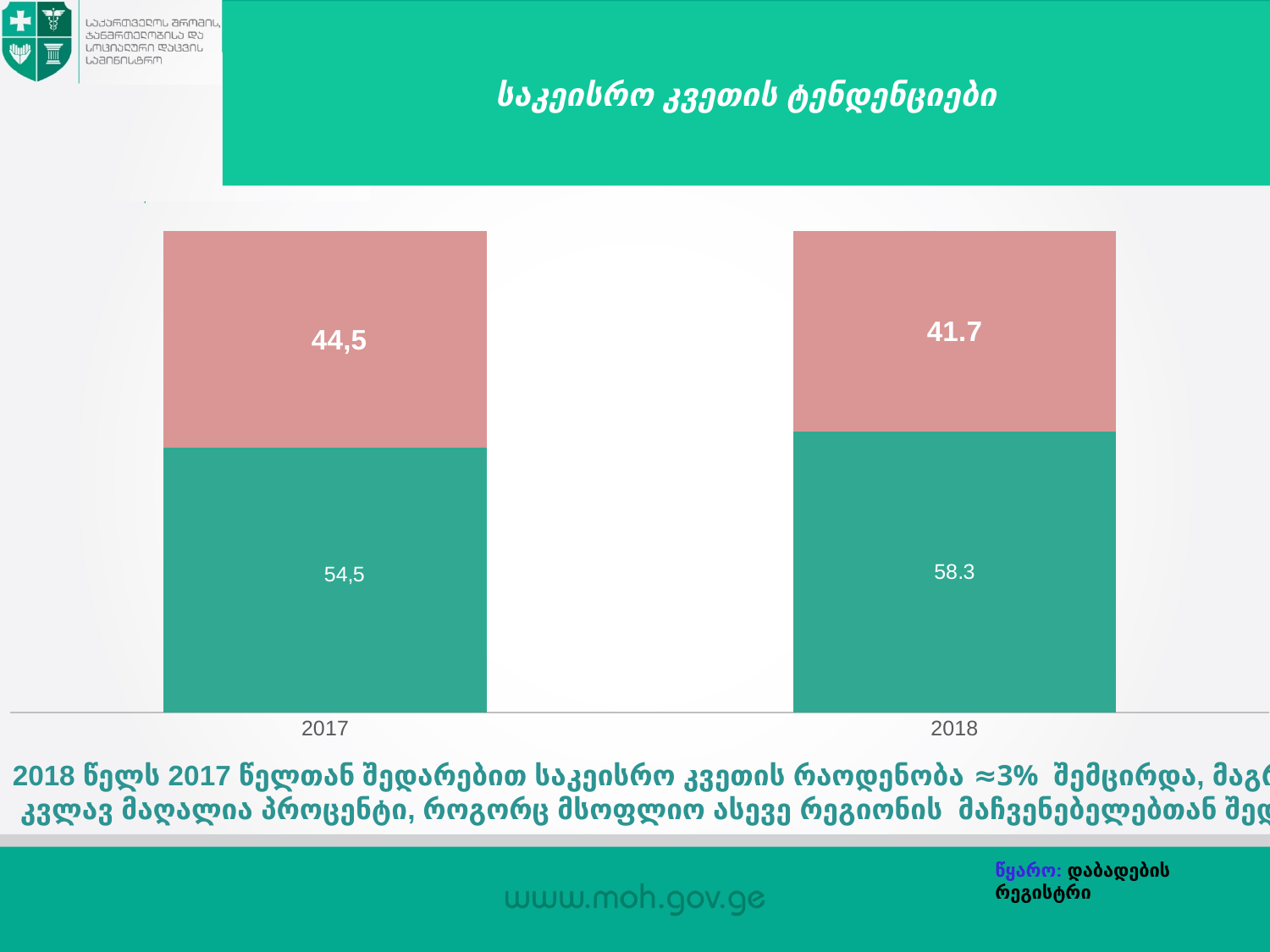
What is the difference between the green segment values for 2018 and 2017? 3.8 Which year has the larger green segment, 2017 or 2018? 2018 How many categories are shown on the x axis? 2 What is the value of the pink segment for 2017? 44,5 Does the pink segment rise or fall from 2017 to 2018? Fall What is the difference between the green and pink segments in 2018? 16.6 What is the value of the green segment for 2018? 58.3 What is the value of the pink segment for 2018? 41.7 Which year has the larger pink segment, 2017 or 2018? 2017 What is the total of the stacked bar for 2018? 100 What is the value of the green segment for 2017? 54,5 What kind of chart is shown on the slide? Stacked bar chart